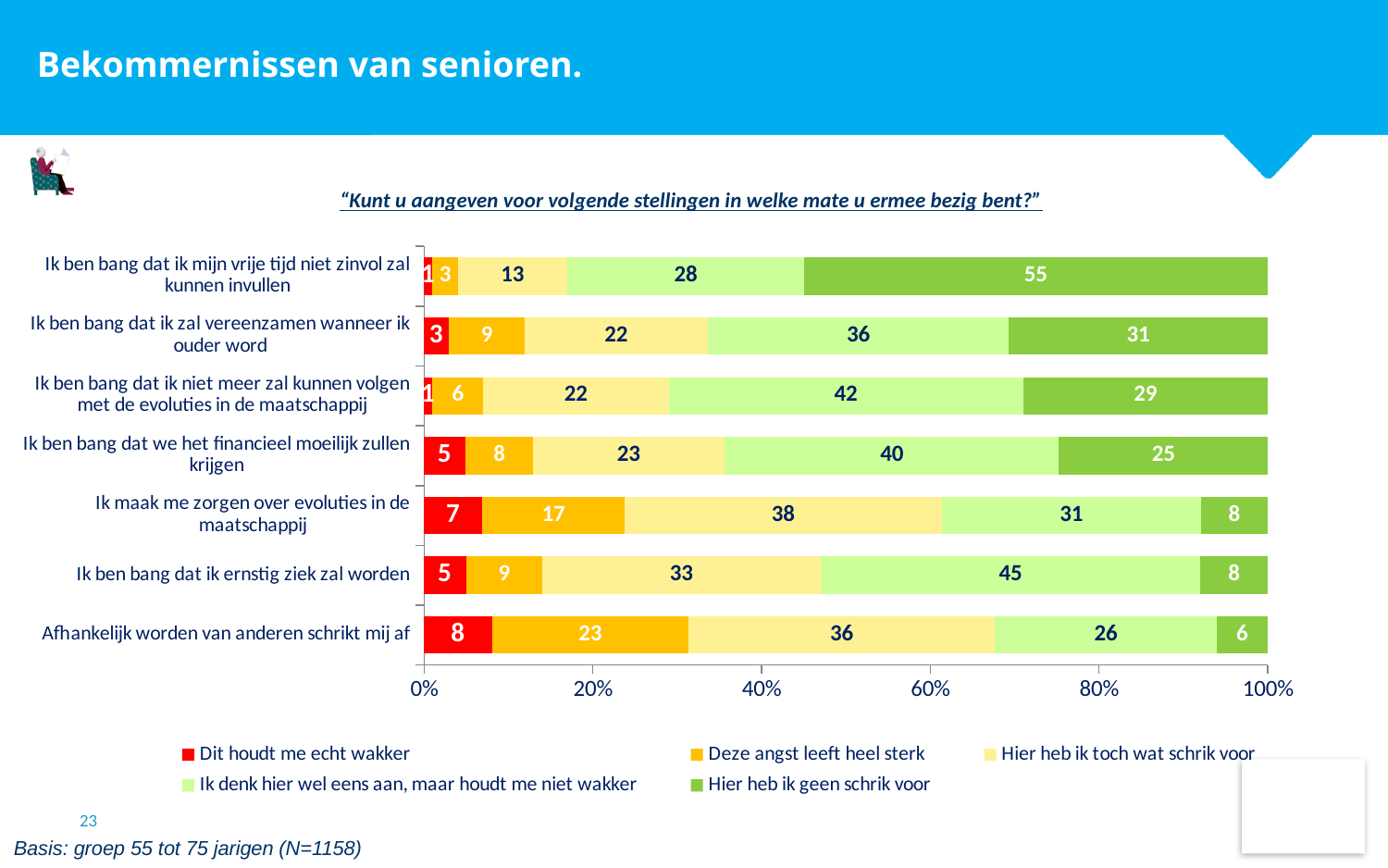
How many statements (categories) are plotted in the chart? 7 What is the value of 'Ik denk hier wel eens aan, maar houdt me niet wakker' for 'Ik ben bang dat ik ernstig ziek zal worden'? 45 Which colour represents 'Dit houdt me echt wakker' in the legend? Red Which statement has the highest value for 'Dit houdt me echt wakker'? Afhankelijk worden van anderen schrikt mij af What is the value of 'Deze angst leeft heel sterk' for 'Ik maak me zorgen over evoluties in de maatschappij'? 17 What is the value of 'Hier heb ik geen schrik voor' for 'Ik ben bang dat ik mijn vrije tijd niet zinvol zal kunnen invullen'? 55 How many series does the legend list? 5 What kind of chart is shown on the slide? Stacked bar chart What is the difference between the 'Hier heb ik geen schrik voor' values for 'Ik ben bang dat ik mijn vrije tijd niet zinvol zal kunnen invullen' and 'Ik ben bang dat ik zal vereenzamen wanneer ik ouder word'? 24 What is the value of 'Dit houdt me echt wakker' for 'Afhankelijk worden van anderen schrikt mij af'? 8 Which statement has the lowest value for 'Hier heb ik geen schrik voor'? Afhankelijk worden van anderen schrikt mij af Which is larger: the 'Hier heb ik toch wat schrik voor' value for 'Ik maak me zorgen over evoluties in de maatschappij' or for 'Ik ben bang dat ik ernstig ziek zal worden'? Ik maak me zorgen over evoluties in de maatschappij